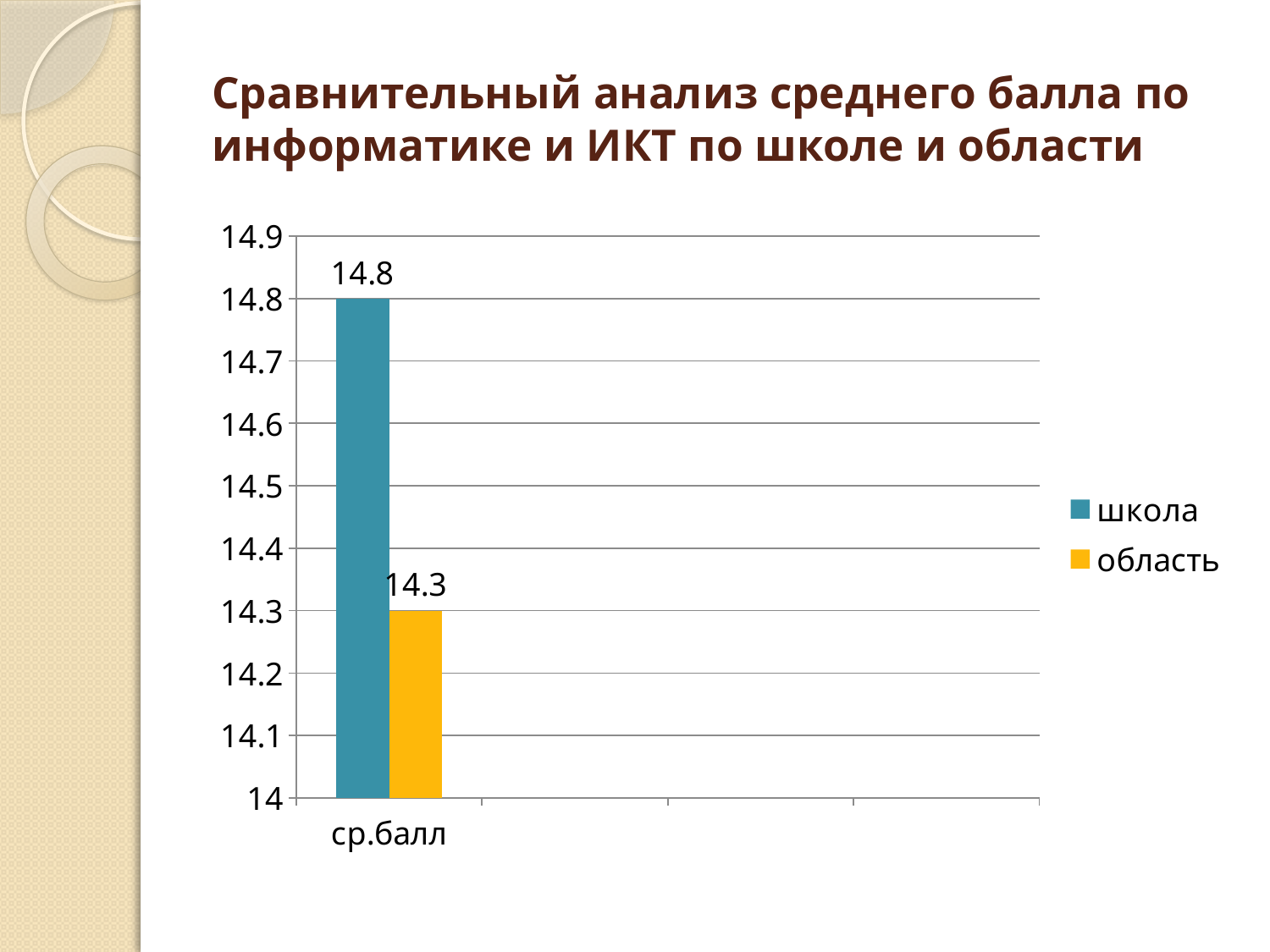
What is the label of the category on the x axis? ср.балл What is the difference between the школа value and the область value? 0.5 Is the value for школа greater or less than 14.5? greater What is the value for область in the ср.балл category? 14.3 Which series has the higher value: школа or область? школа Is the value for область greater or less than 14.5? less How many categories are shown on the x axis? 1 What is the value for школа in the ср.балл category? 14.8 What kind of chart is shown on the slide? bar chart How many series does the legend list? 2 Which series has the lowest value on the chart? область What colour is the bar for область? yellow